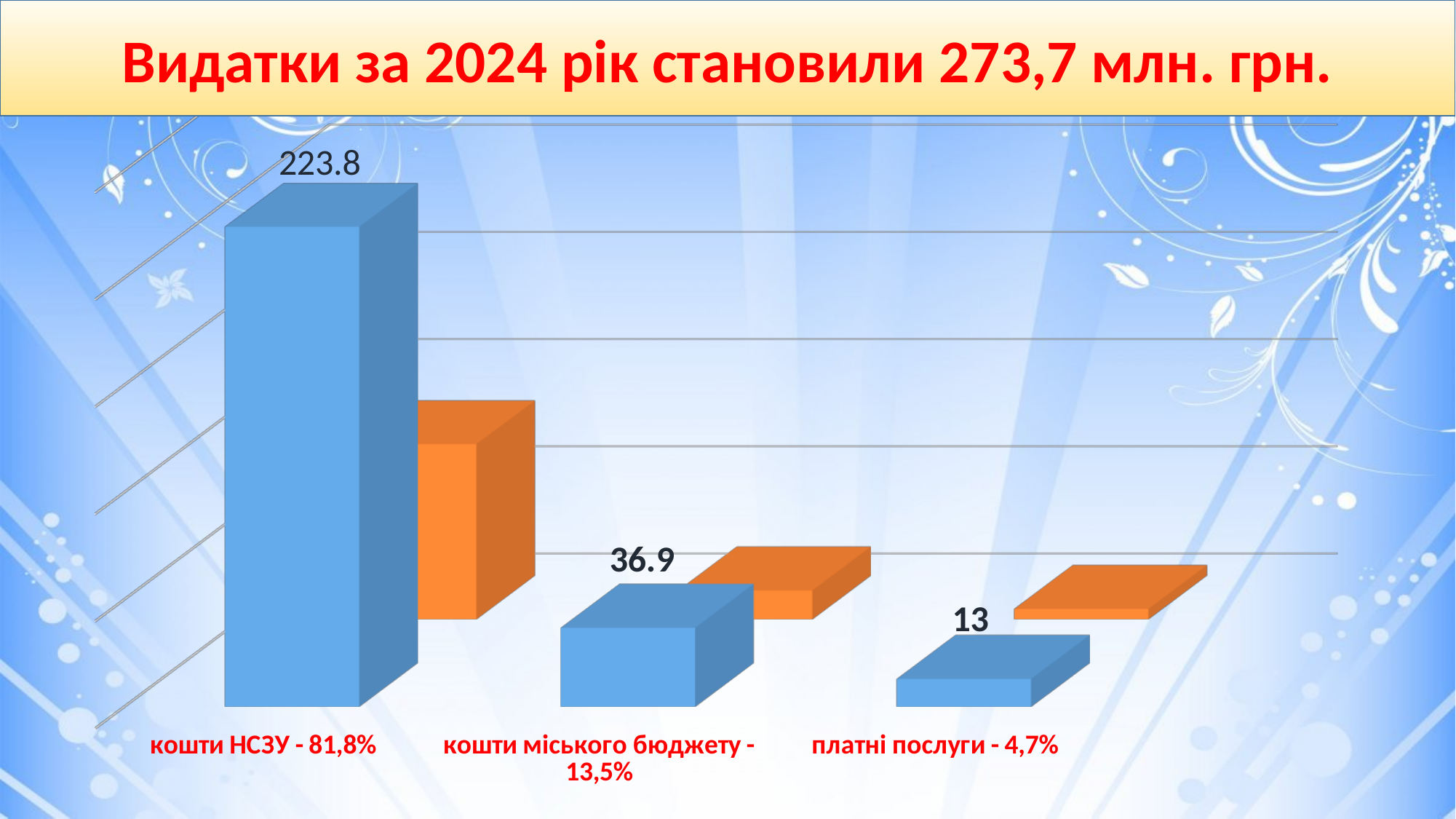
What percentage share is given in the x-axis label for кошти НСЗУ? 81,8% What is the difference between the labelled values for кошти міського бюджету and платні послуги? 23.9 Do the labelled values rise or fall from left to right along the x axis? fall How many categories are shown on the x axis? 3 What is the value shown for кошти міського бюджету? 36.9 Which category has the highest labelled value? кошти НСЗУ Which category has the lowest labelled value? платні послуги What is the value shown for платні послуги? 13 What is the value shown for кошти НСЗУ? 223.8 Which is larger, the value for кошти міського бюджету or the value for платні послуги? кошти міського бюджету What kind of chart is shown on the slide? bar chart What is the difference between the labelled values for кошти НСЗУ and кошти міського бюджету? 186.9